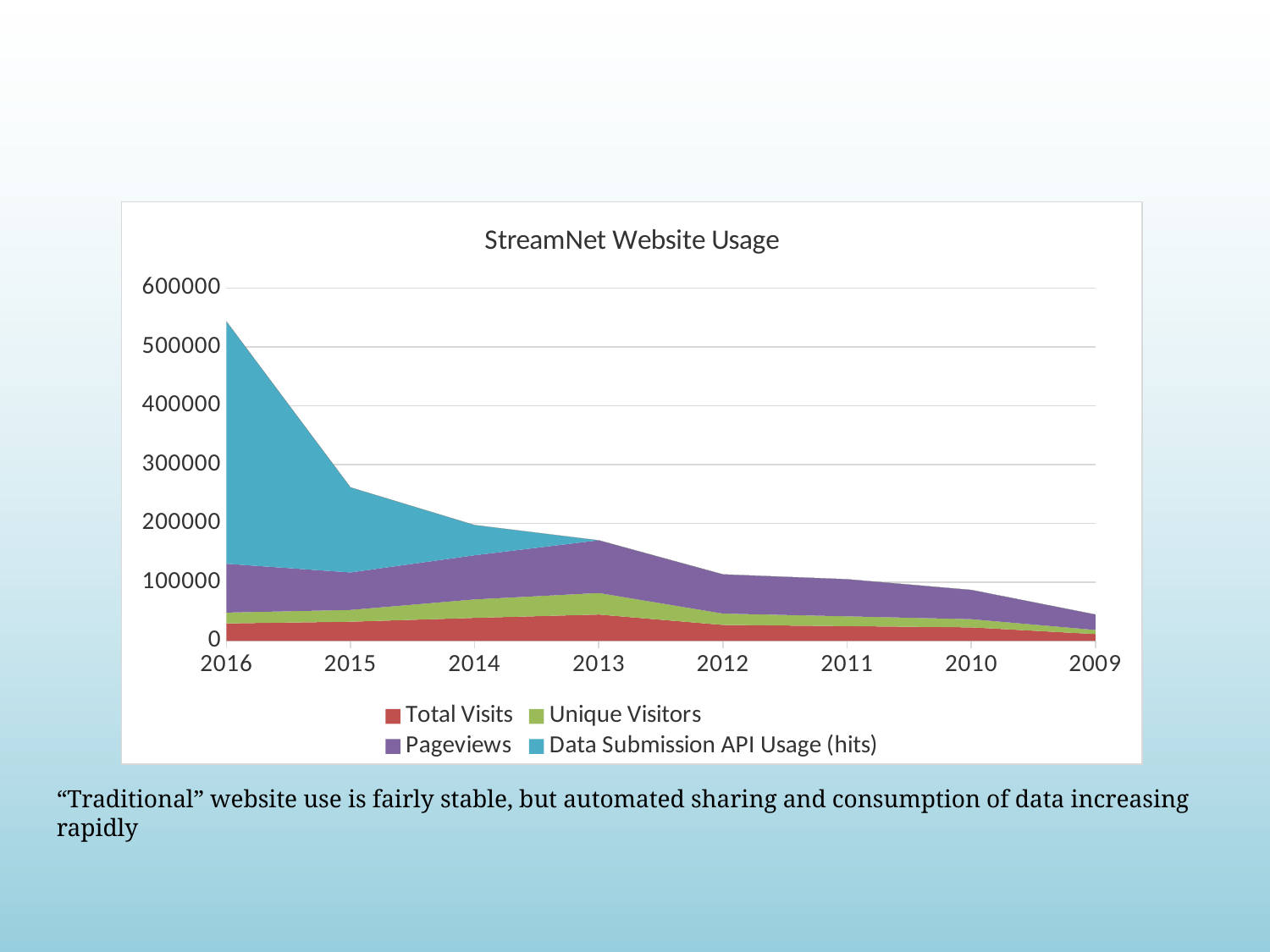
Is the total stacked value for 2016 greater or less than 500000? greater How many years are shown along the x axis? 8 Which year has a larger total stacked value, 2016 or 2015? 2016 What is the title of the chart? StreamNet Website Usage In which year is the total stacked value lowest? 2009 Is the total stacked value for 2015 greater or less than 200000? greater In which year is the total stacked value highest? 2016 Moving from left (2016) to right (2009) along the x axis, does the total stacked value rise or fall? fall Is the total stacked value for 2009 greater or less than 100000? less How many series does the legend list? 4 What kind of chart is shown on the slide? Stacked area chart Which series is shown in blue in the legend? Data Submission API Usage (hits)